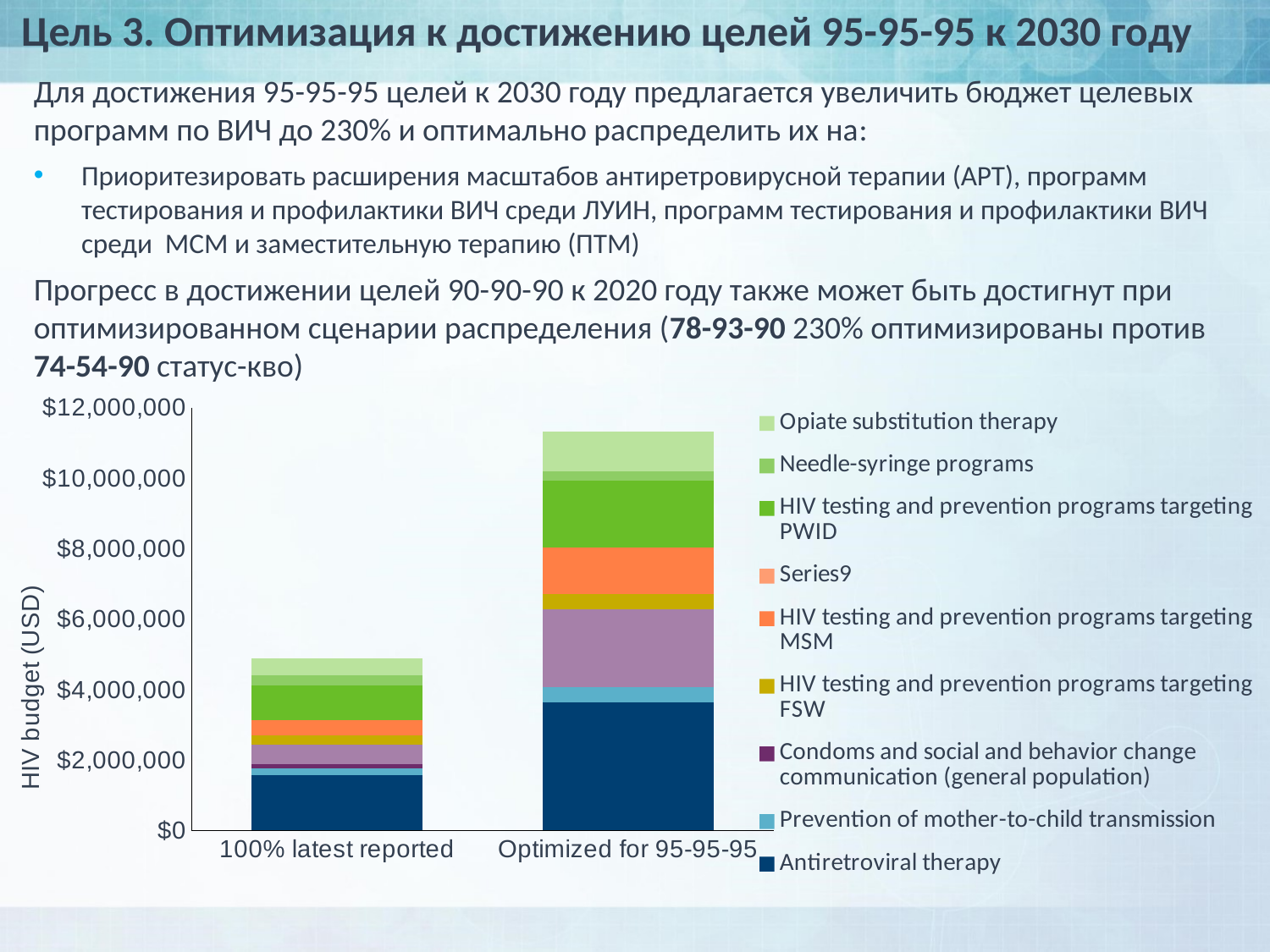
Which category has the lowest total HIV budget? 100% latest reported What kind of chart is shown on the slide? Stacked bar chart Which category has the highest total HIV budget? Optimized for 95-95-95 How many series does the chart's legend list? 9 Is the total value of the '100% latest reported' bar greater or less than $6,000,000? less How many bars (categories) are plotted on the x axis of the chart? 2 Which series is shown at the bottom of each stacked bar in dark blue? Antiretroviral therapy Is the total value of the '100% latest reported' bar greater or less than $4,000,000? greater Is the Antiretroviral therapy segment of the 'Optimized for 95-95-95' bar greater or less than $4,000,000? less What is the label of the chart's y axis? HIV budget (USD) Which bar has the larger total HIV budget, '100% latest reported' or 'Optimized for 95-95-95'? Optimized for 95-95-95